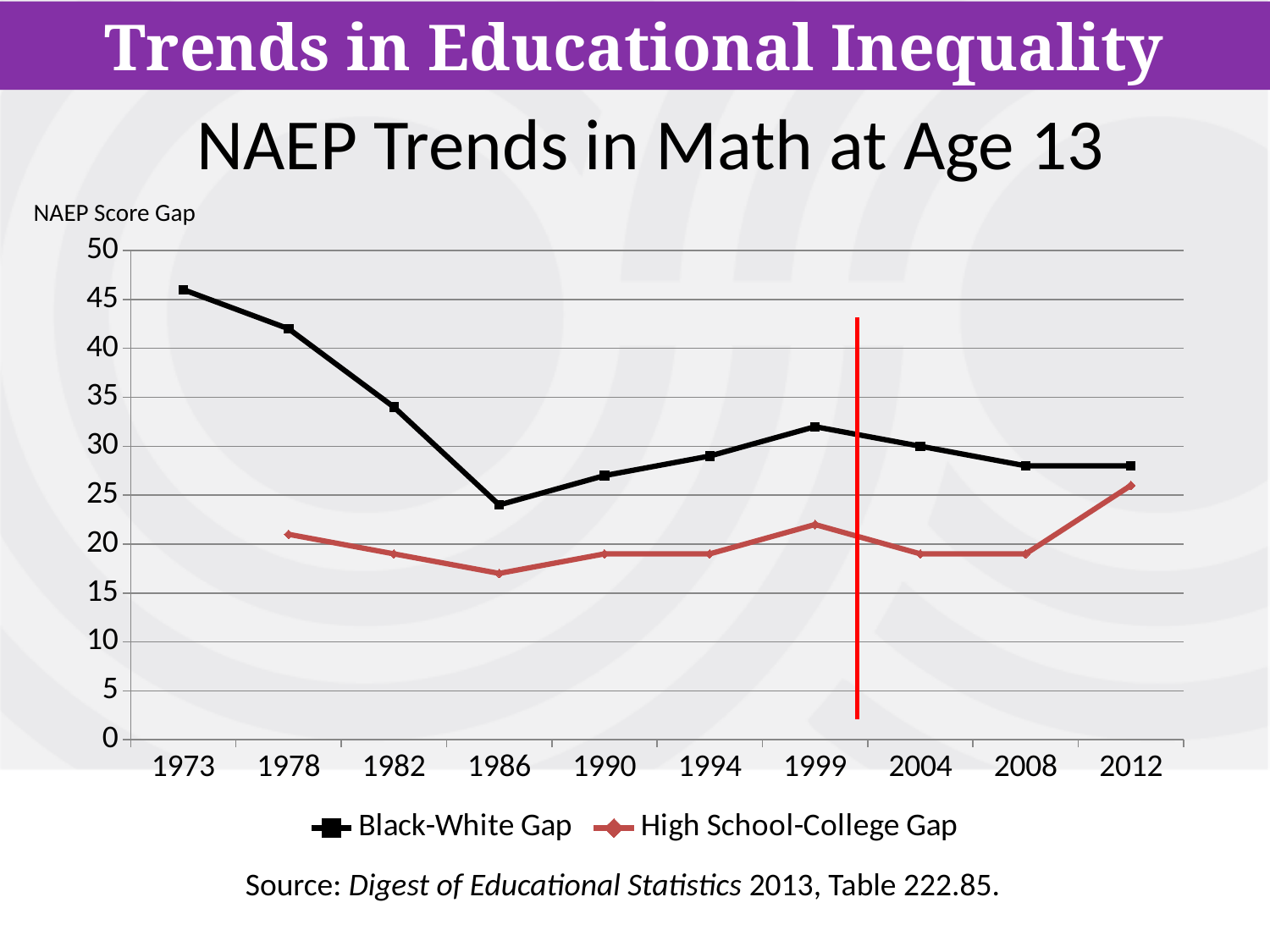
In which year is the Black-White Gap lowest? 1986 In which year is the High School-College Gap highest? 2012 Is the Black-White Gap in 1973 greater or less than 40? greater In 1999, which is larger: the Black-White Gap or the High School-College Gap? Black-White Gap In which year is the Black-White Gap highest? 1973 What is the title of the chart? NAEP Trends in Math at Age 13 How many series does the legend list? 2 Is the High School-College Gap in 1986 greater or less than 20? less What kind of chart is shown on the slide? line chart How many years are labelled on the x axis? 10 In which year is the High School-College Gap lowest? 1986 Does the Black-White Gap rise or fall from 1973 to 1986? fall